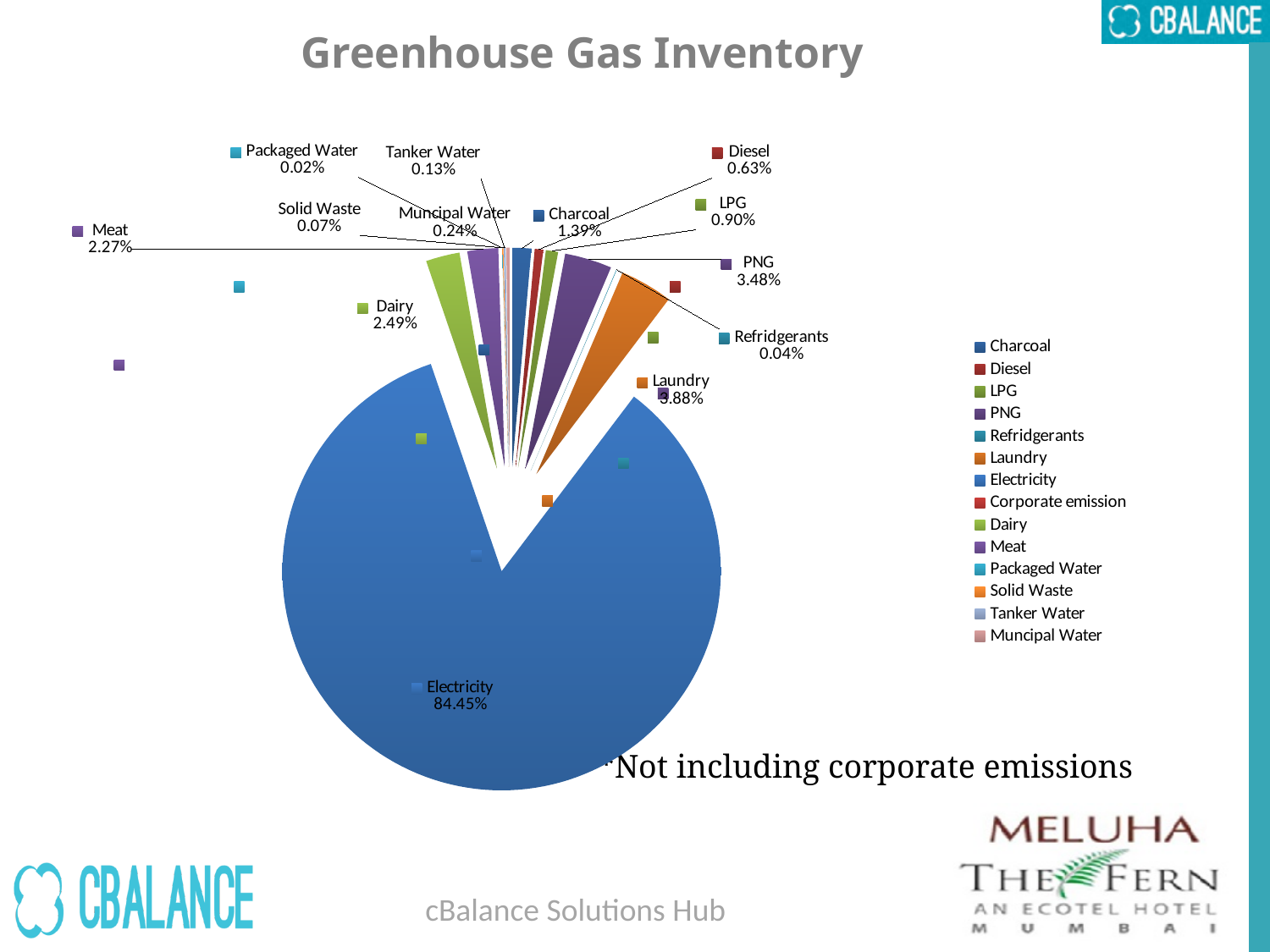
Which category has the largest share of the pie? Electricity What is the percentage shown for Dairy? 2.49% What is the percentage shown for PNG? 3.48% What is the title of the chart? Greenhouse Gas Inventory How many entries does the legend list? 14 What kind of chart is shown on the slide? Pie chart What is the percentage shown for Diesel? 0.63% What is the percentage shown for Charcoal? 1.39% What share of the pie does Electricity account for? 84.45% What is the difference between the shares of PNG and Meat? 1.21% Which category has the smallest share of the pie? Packaged Water Which has a larger share, PNG or Meat? PNG